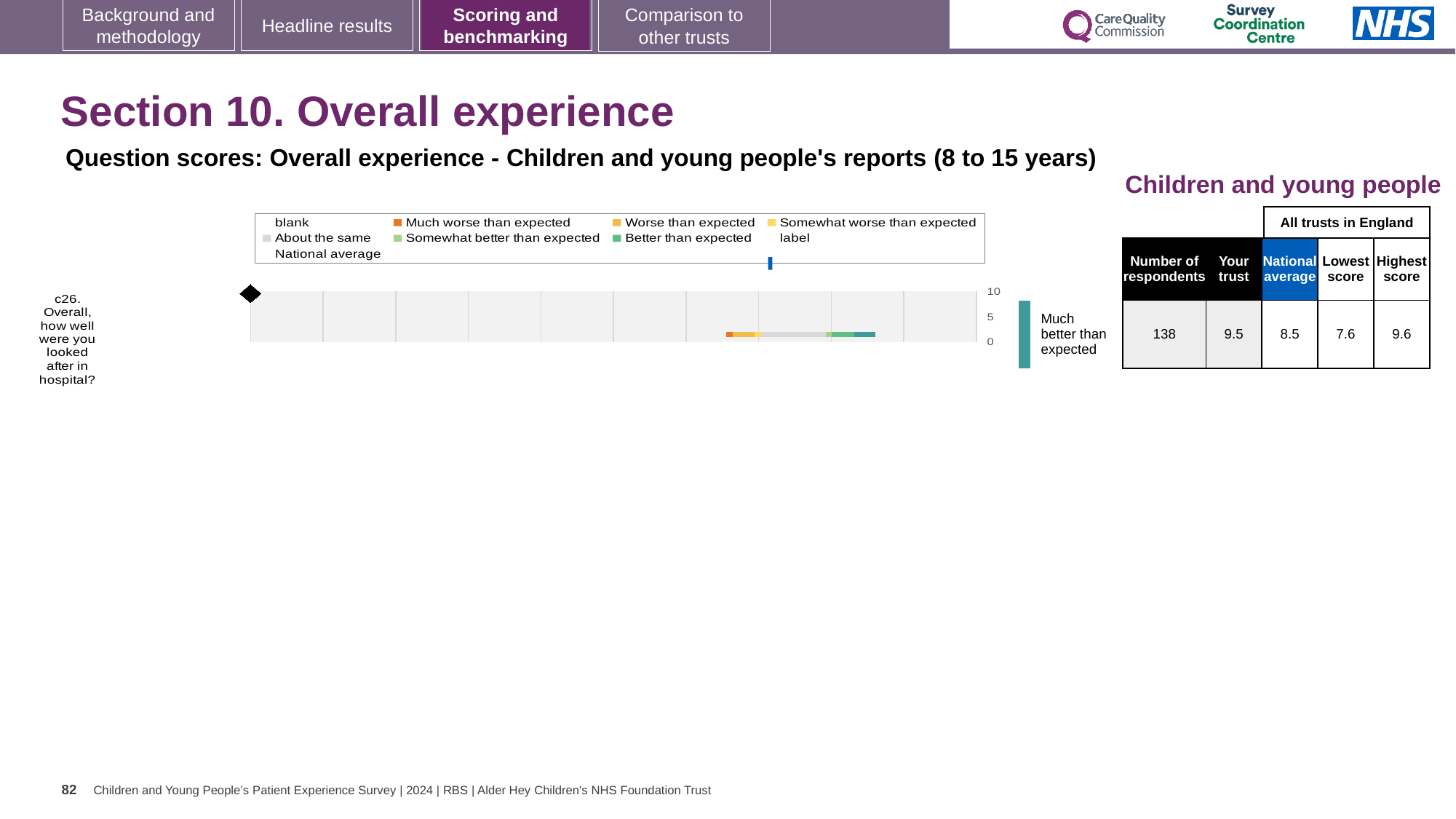
What rating band is shown next to the chart for question c26? Much better than expected According to the table beside the chart, what is the lowest score among all trusts in England for question c26? 7.6 According to the table beside the chart, how many respondents answered question c26? 138 According to the table beside the chart, what is the highest score among all trusts in England for question c26? 9.6 Which is higher for question c26: the 'Your trust' score or the national average? Your trust Which question is plotted in the chart? c26. Overall, how well were you looked after in hospital? According to the table beside the chart, what is the 'Your trust' score for question c26? 9.5 What is the highest value shown on the chart's score axis? 10 What colour does the legend use for 'Much worse than expected'? Orange How many survey questions are plotted in the chart? 1 According to the table beside the chart, what is the national average score for question c26? 8.5 What kind of chart is shown on the slide? Bar chart